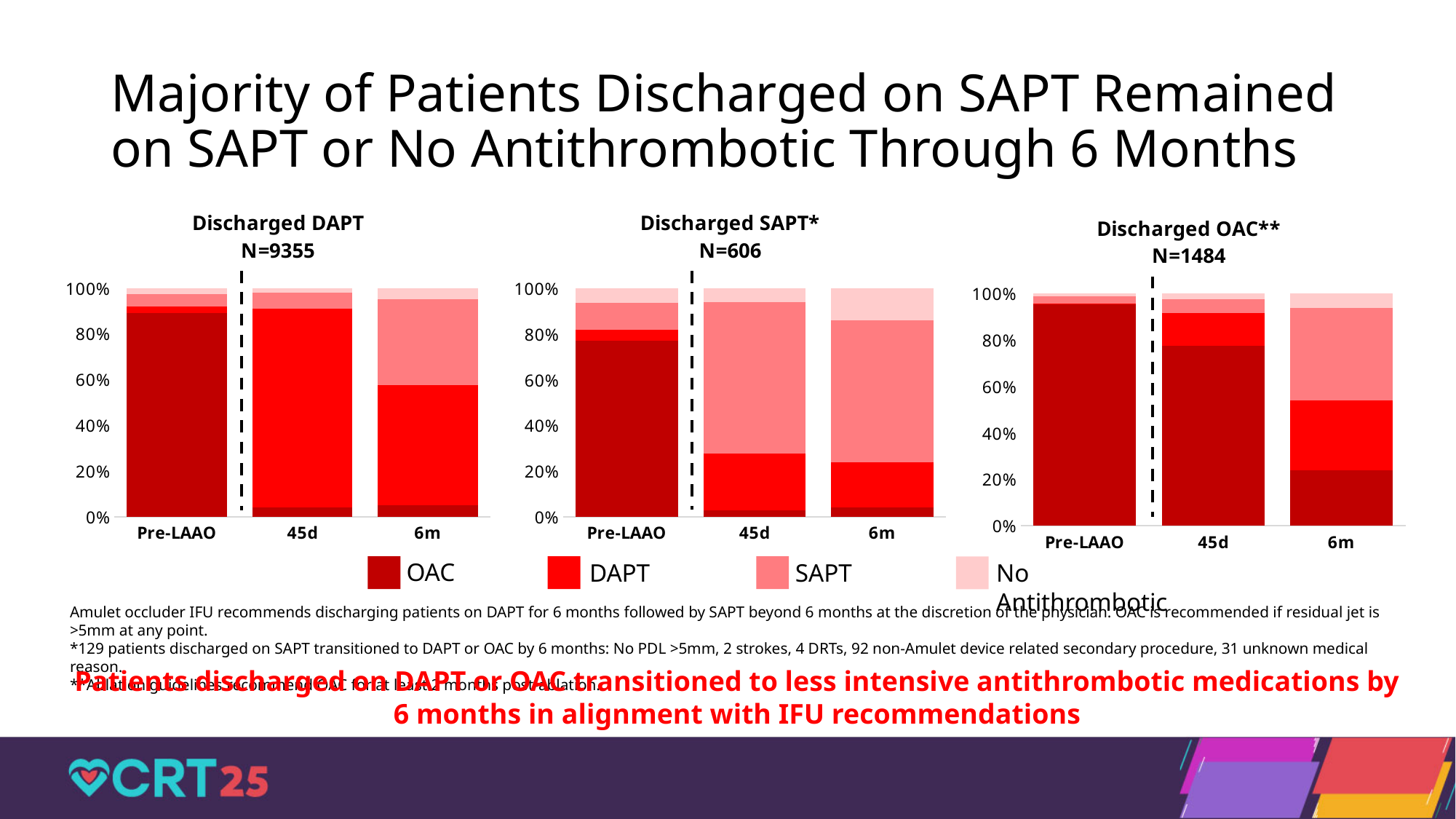
How many series does the legend list? 4 What kind of chart is the Discharged DAPT chart? Stacked bar chart In the Discharged OAC** chart, is the OAC share at Pre-LAAO greater or less than 80%? greater In the Discharged OAC** chart, which is larger: the OAC share at Pre-LAAO or at 6m? Pre-LAAO What is the N shown for the Discharged SAPT* chart? N=606 In the Discharged SAPT* chart, is the OAC share at 6m greater or less than 20%? less In the Discharged DAPT chart, is the OAC share at 6m greater or less than 20%? less How many time-point categories are shown on the x axis of the Discharged SAPT* chart? 3 In the Discharged OAC** chart, does the OAC share rise or fall from Pre-LAAO to 6m? fall